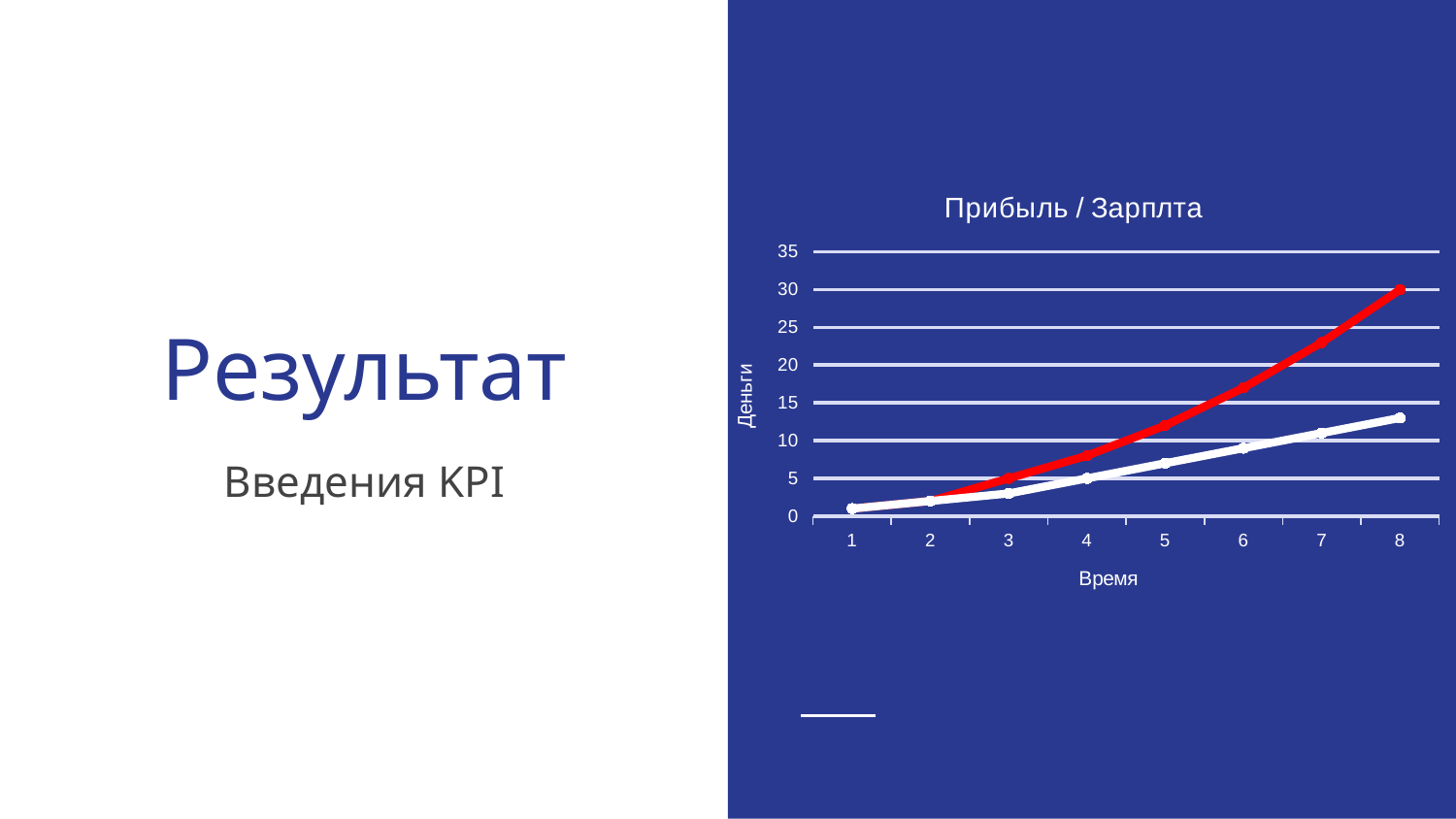
Is the value of the red line at x = 8 greater or less than 25? greater Is the value of the white line at x = 8 greater or less than 15? less Do the values of the white line rise or fall as the x axis goes from 1 to 8? rise What is the label of the x axis? Время What kind of chart is shown on the slide? line chart How many lines are plotted on the chart? 2 How many points are plotted along the x axis? 8 At x = 8, which line has the larger value, the red line or the white line? the red line Is the value of the red line at x = 4 greater or less than 5? greater Do the values of the red line rise or fall as the x axis goes from 1 to 8? rise What is the title of the chart? Прибыль / Зарплта